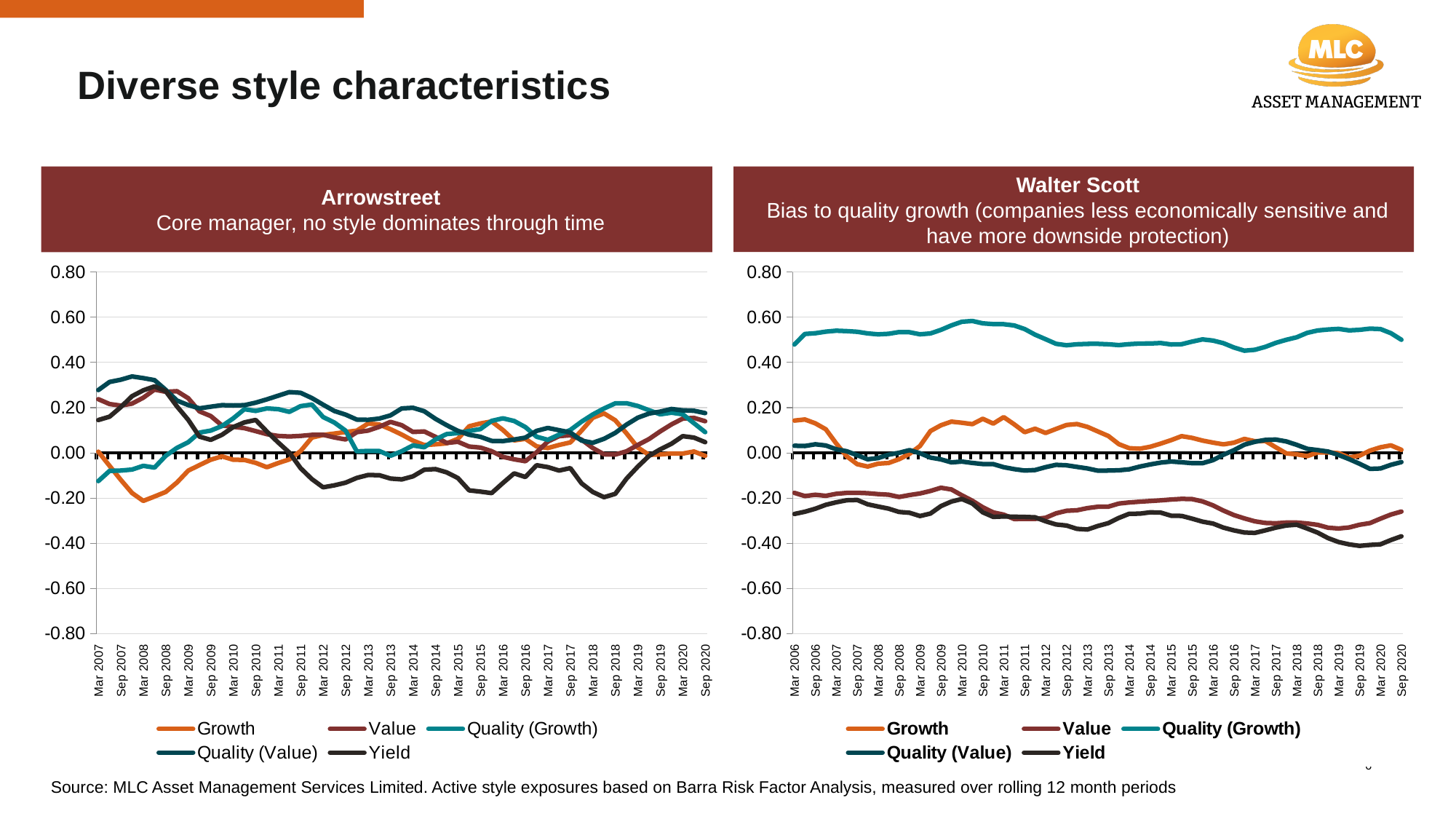
What kind of chart is the Arrowstreet chart? line chart In the Walter Scott chart, which series has the highest values across the whole period? Quality (Growth) In the Walter Scott chart, which is larger at Sep 2020: Quality (Growth) or Yield? Quality (Growth) In the Arrowstreet chart, is the value for Growth at Mar 2008 greater or less than 0.00? less In the Walter Scott chart, is the value for Yield at Sep 2019 greater or less than -0.20? less How many series does the legend of the Walter Scott chart list? 5 In the Arrowstreet chart, which is larger at Mar 2008: Quality (Value) or Growth? Quality (Value) In the Walter Scott chart, is the value for Quality (Growth) at Mar 2010 greater or less than 0.40? greater Which manager is the left-hand chart about? Arrowstreet In the Walter Scott chart, which series has the lowest value at Sep 2019? Yield In the Walter Scott chart, does the Quality (Growth) line rise or fall from Mar 2006 to Mar 2010? rise